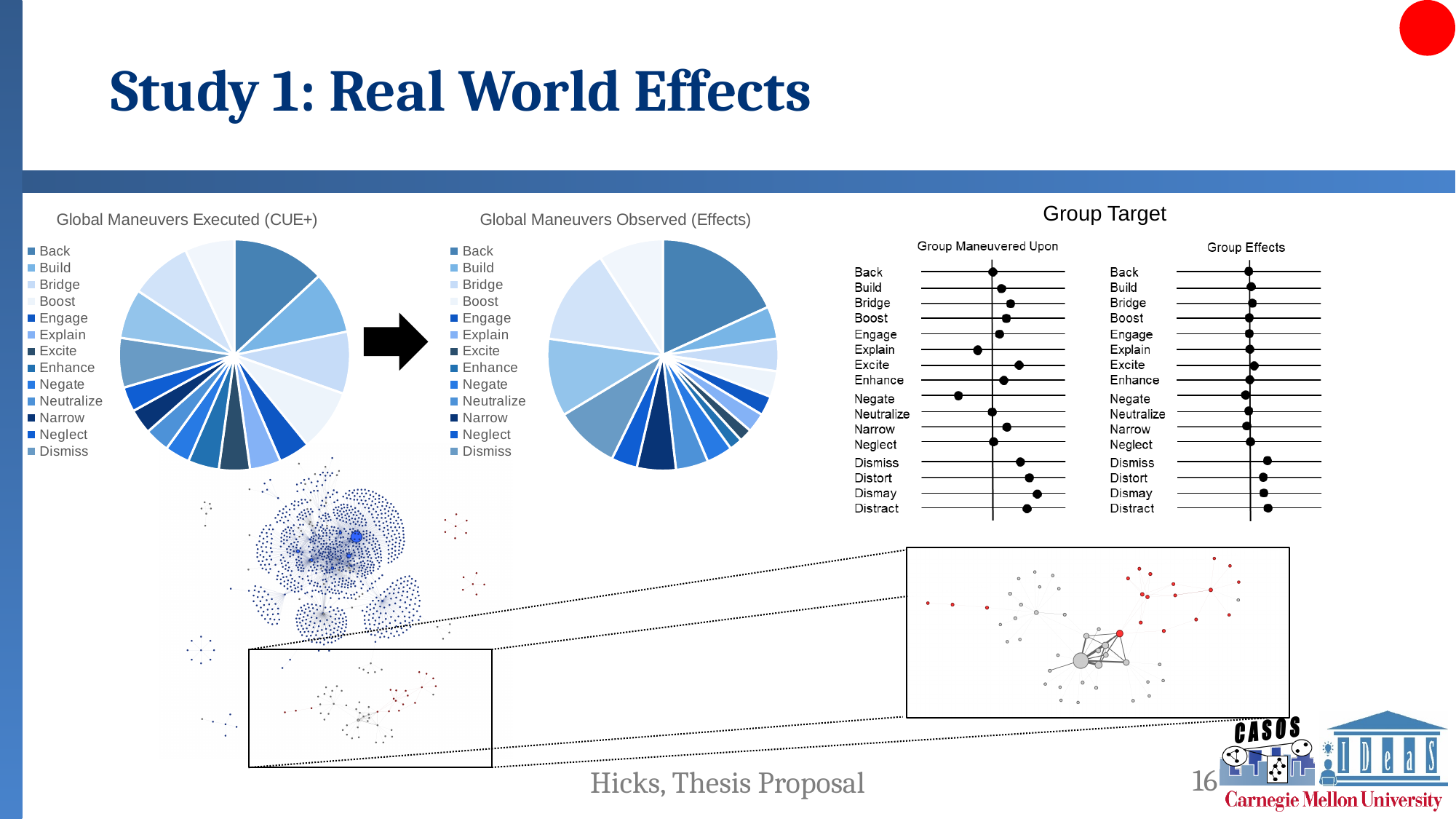
What is the first entry in the legend of the 'Global Maneuvers Executed (CUE+)' pie chart? Back How many pie charts are shown on the slide? 2 In the 'Group Maneuvered Upon' dot plot, which category has its dot farthest to the left? Negate How many categories does the legend of the 'Global Maneuvers Executed (CUE+)' pie chart list? 13 What is the last entry in the legend of the 'Global Maneuvers Observed (Effects)' pie chart? Dismiss What kind of chart is 'Global Maneuvers Executed (CUE+)'? pie chart In the 'Global Maneuvers Executed (CUE+)' pie chart, which slice is larger, Back or Excite? Back How many categories are listed in the 'Group Maneuvered Upon' dot plot under 'Group Target'? 16 In the 'Global Maneuvers Observed (Effects)' pie chart, which category has the largest slice? Back In the 'Global Maneuvers Observed (Effects)' pie chart, which slice is larger, Back or Engage? Back In the 'Global Maneuvers Executed (CUE+)' pie chart, which category has the largest slice? Back